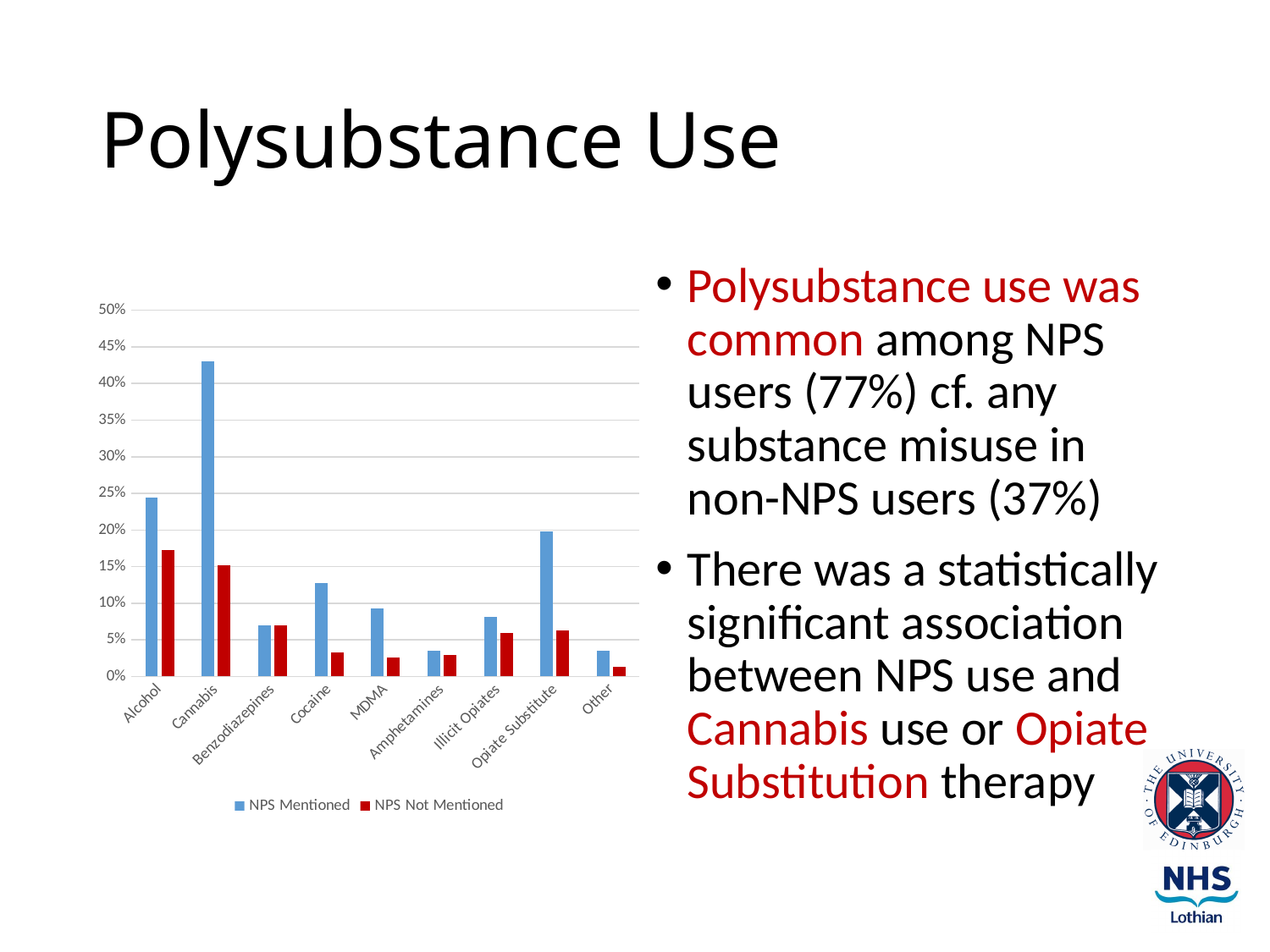
How many series does the chart's legend list? 2 How many substance categories are shown on the x axis of the chart? 9 Which category has the highest value for NPS Not Mentioned? Alcohol Which is larger: the NPS Mentioned value for Alcohol or the NPS Mentioned value for Opiate Substitute? Alcohol Which category has the highest value for NPS Mentioned? Cannabis What kind of chart is shown on the slide? bar chart Is the NPS Mentioned value for Cannabis greater or less than 40%? greater Is the NPS Mentioned value for Opiate Substitute greater or less than 15%? greater For Cannabis, which series has the larger value, NPS Mentioned or NPS Not Mentioned? NPS Mentioned Is the NPS Not Mentioned value for Cocaine greater or less than 5%? less Which category has the lowest value for NPS Not Mentioned? Other Which colour represents the NPS Not Mentioned series in the chart? red